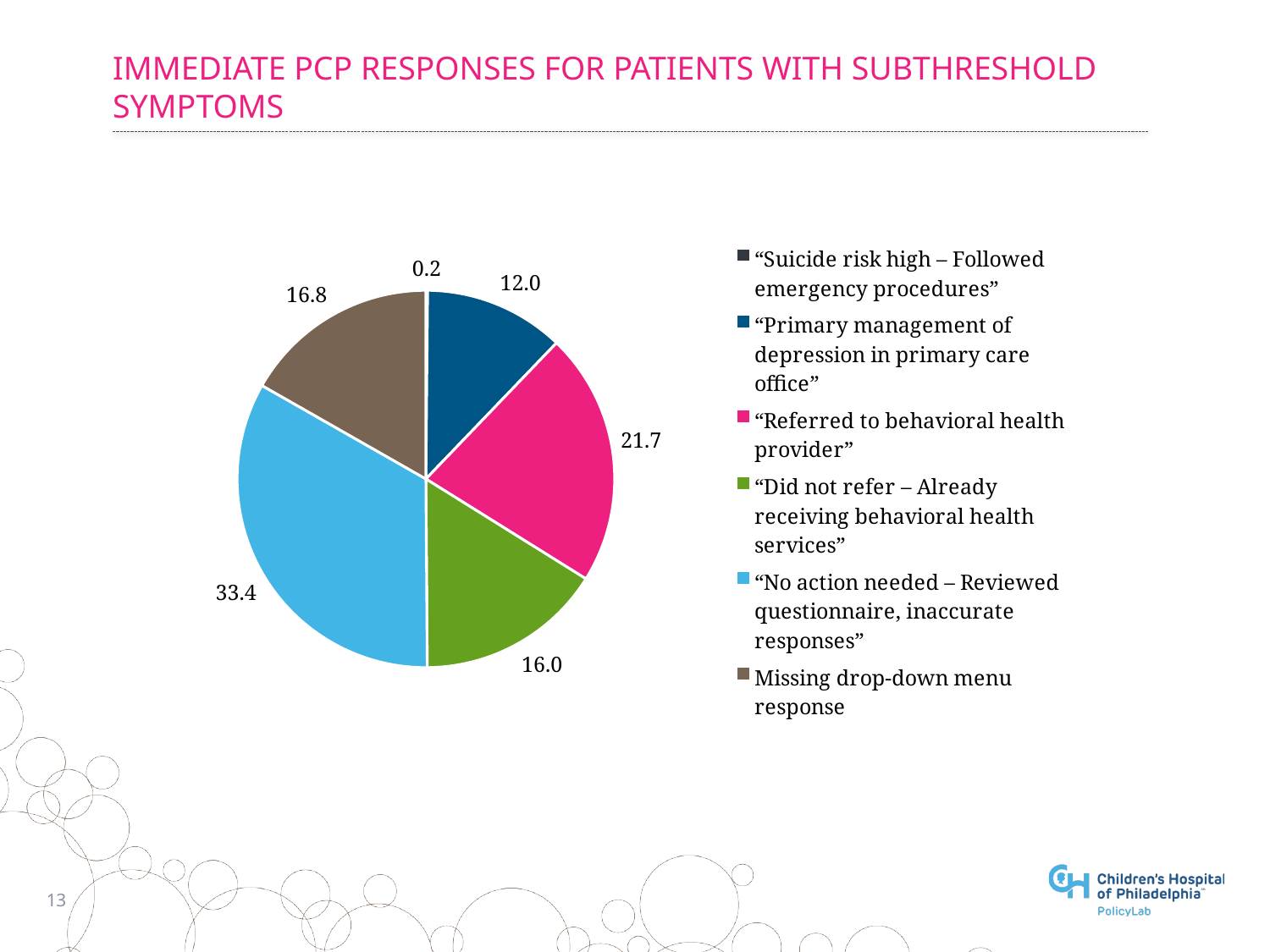
What is the value for "No action needed – Reviewed questionnaire, inaccurate responses"? 33.4 How many categories does the legend list? 6 What type of chart is shown on the slide? Pie chart What is the value for "Primary management of depression in primary care office"? 12.0 What is the value for "Referred to behavioral health provider"? 21.7 What is the title of the slide containing the chart? Immediate PCP Responses for Patients with Subthreshold Symptoms Which is larger: the value for "Did not refer – Already receiving behavioral health services" or the value for "Primary management of depression in primary care office"? "Did not refer – Already receiving behavioral health services" Which category has the smallest slice of the pie? "Suicide risk high – Followed emergency procedures" What is the value for "Suicide risk high – Followed emergency procedures"? 0.2 What is the value for "Missing drop-down menu response"? 16.8 Which category has the largest slice of the pie? "No action needed – Reviewed questionnaire, inaccurate responses" What is the difference between the values for "No action needed – Reviewed questionnaire, inaccurate responses" and "Referred to behavioral health provider"? 11.7